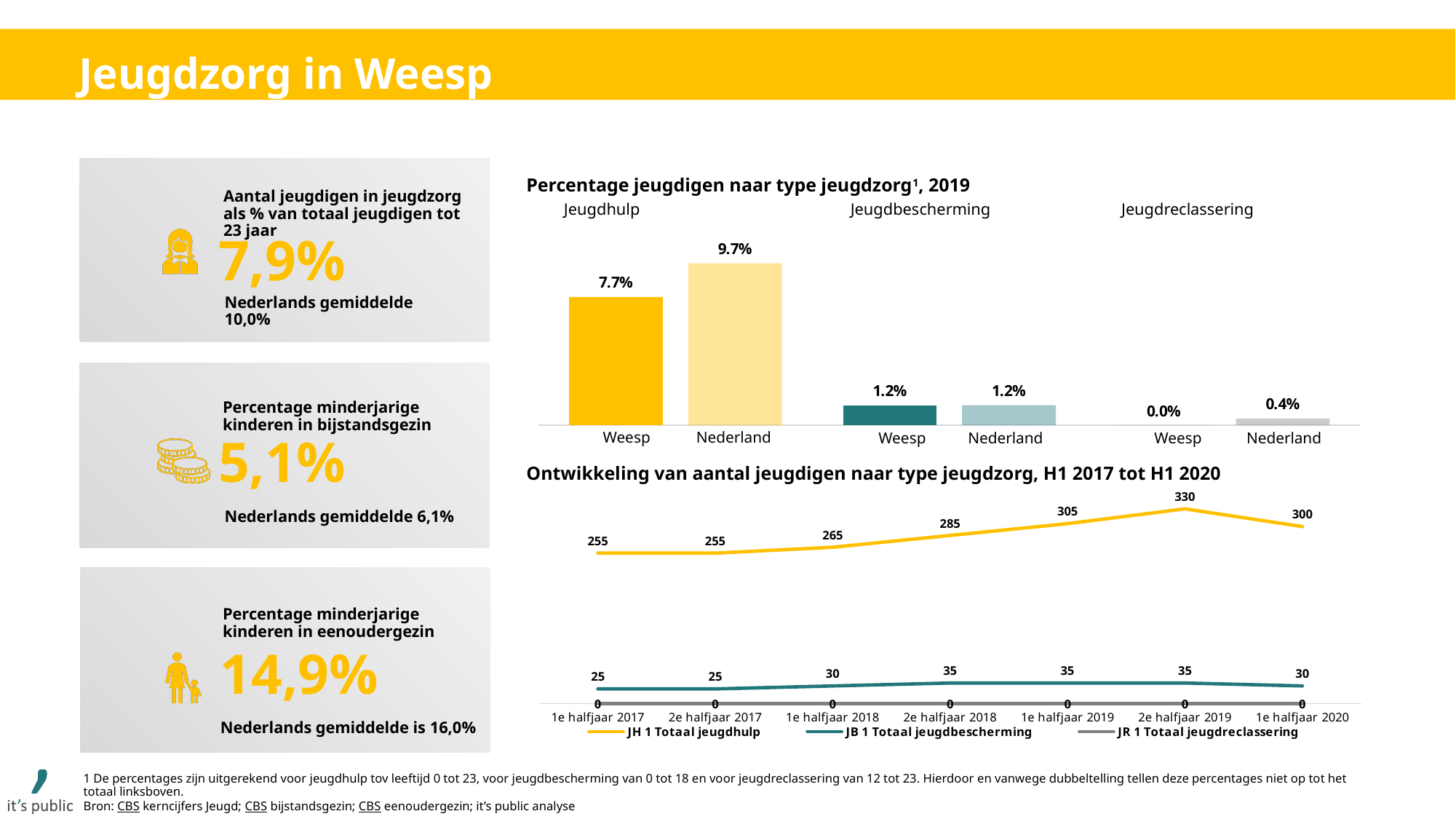
In the chart 'Ontwikkeling van aantal jeugdigen naar type jeugdzorg, H1 2017 tot H1 2020', how many series does the legend list? 3 In the chart 'Ontwikkeling van aantal jeugdigen naar type jeugdzorg, H1 2017 tot H1 2020', what is the value of JB 1 Totaal jeugdbescherming in 1e halfjaar 2020? 30 What kind of chart is 'Percentage jeugdigen naar type jeugdzorg, 2019'? Bar chart In the chart 'Ontwikkeling van aantal jeugdigen naar type jeugdzorg, H1 2017 tot H1 2020', what is the difference in JH 1 Totaal jeugdhulp between 1e halfjaar 2017 and 2e halfjaar 2019? 75 In the chart 'Percentage jeugdigen naar type jeugdzorg, 2019', what is the difference between the Jeugdhulp values for Nederland and Weesp? 2.0% In the chart 'Percentage jeugdigen naar type jeugdzorg, 2019', which is larger for Jeugdbescherming: Weesp or Nederland? They are equal (1.2%) In the chart 'Percentage jeugdigen naar type jeugdzorg, 2019', what is the Jeugdhulp value for Weesp? 7.7% In the chart 'Ontwikkeling van aantal jeugdigen naar type jeugdzorg, H1 2017 tot H1 2020', what is the value of JH 1 Totaal jeugdhulp in 2e halfjaar 2019? 330 In the chart 'Percentage jeugdigen naar type jeugdzorg, 2019', what is the Jeugdreclassering value for Nederland? 0.4% In the chart 'Ontwikkeling van aantal jeugdigen naar type jeugdzorg, H1 2017 tot H1 2020', how many time points are shown on the x axis? 7 In the chart 'Percentage jeugdigen naar type jeugdzorg, 2019', what is the Jeugdhulp value for Nederland? 9.7% In the chart 'Percentage jeugdigen naar type jeugdzorg, 2019', which bar is the highest? Nederland (Jeugdhulp)